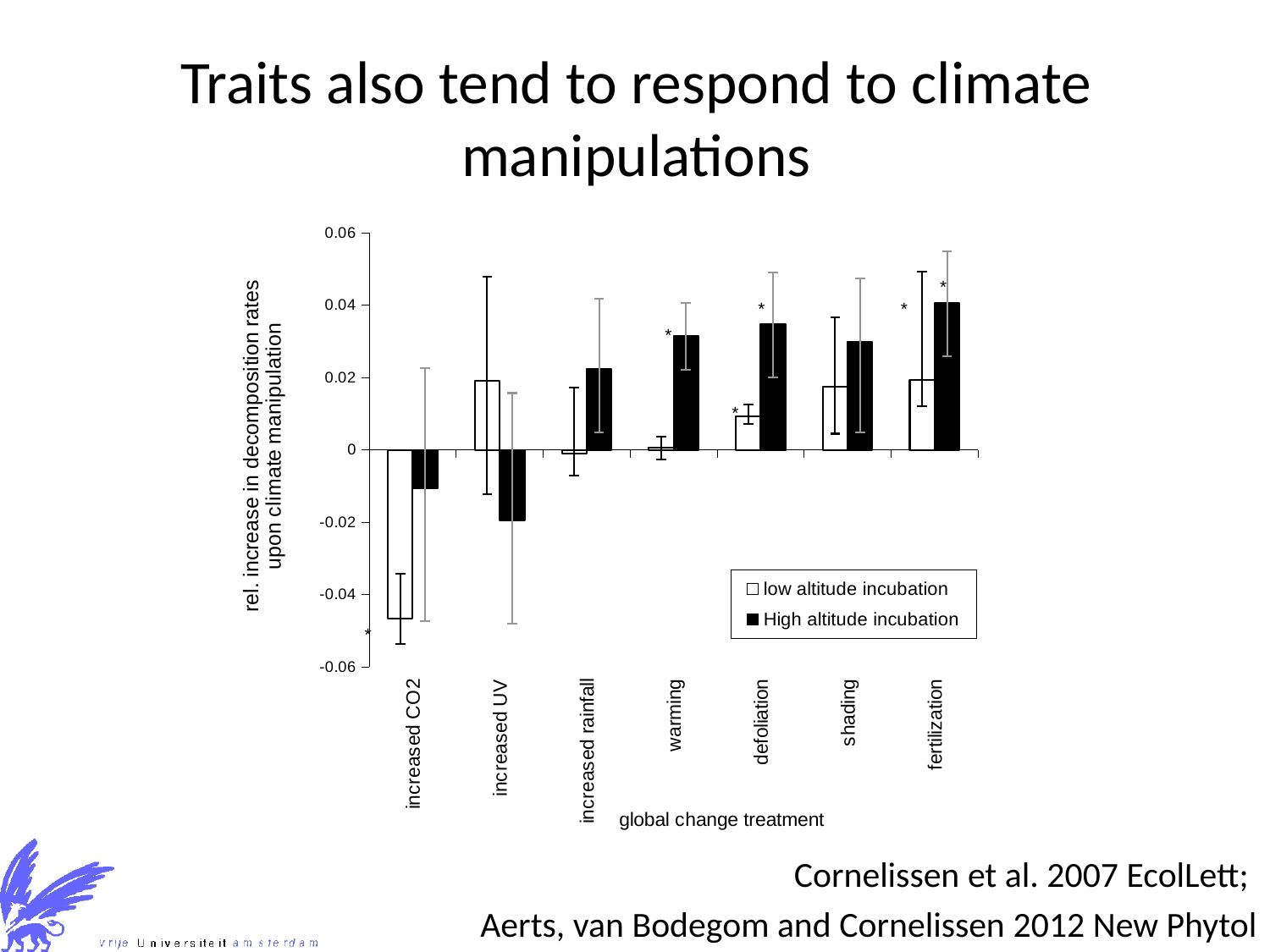
Is the High altitude incubation value for increased UV greater or less than 0? less Is the High altitude incubation value for warming greater or less than 0.02? greater Which series is drawn with black (filled) bars? High altitude incubation Which treatment has the highest value for High altitude incubation? fertilization What is the label of the x axis? global change treatment Is the low altitude incubation value for increased CO2 greater or less than -0.04? less What kind of chart is shown on the slide? bar chart How many series does the legend list? 2 How many global change treatments are shown on the x axis? 7 For warming, which series has the larger value: low altitude incubation or High altitude incubation? High altitude incubation Which treatment has the lowest value for low altitude incubation? increased CO2